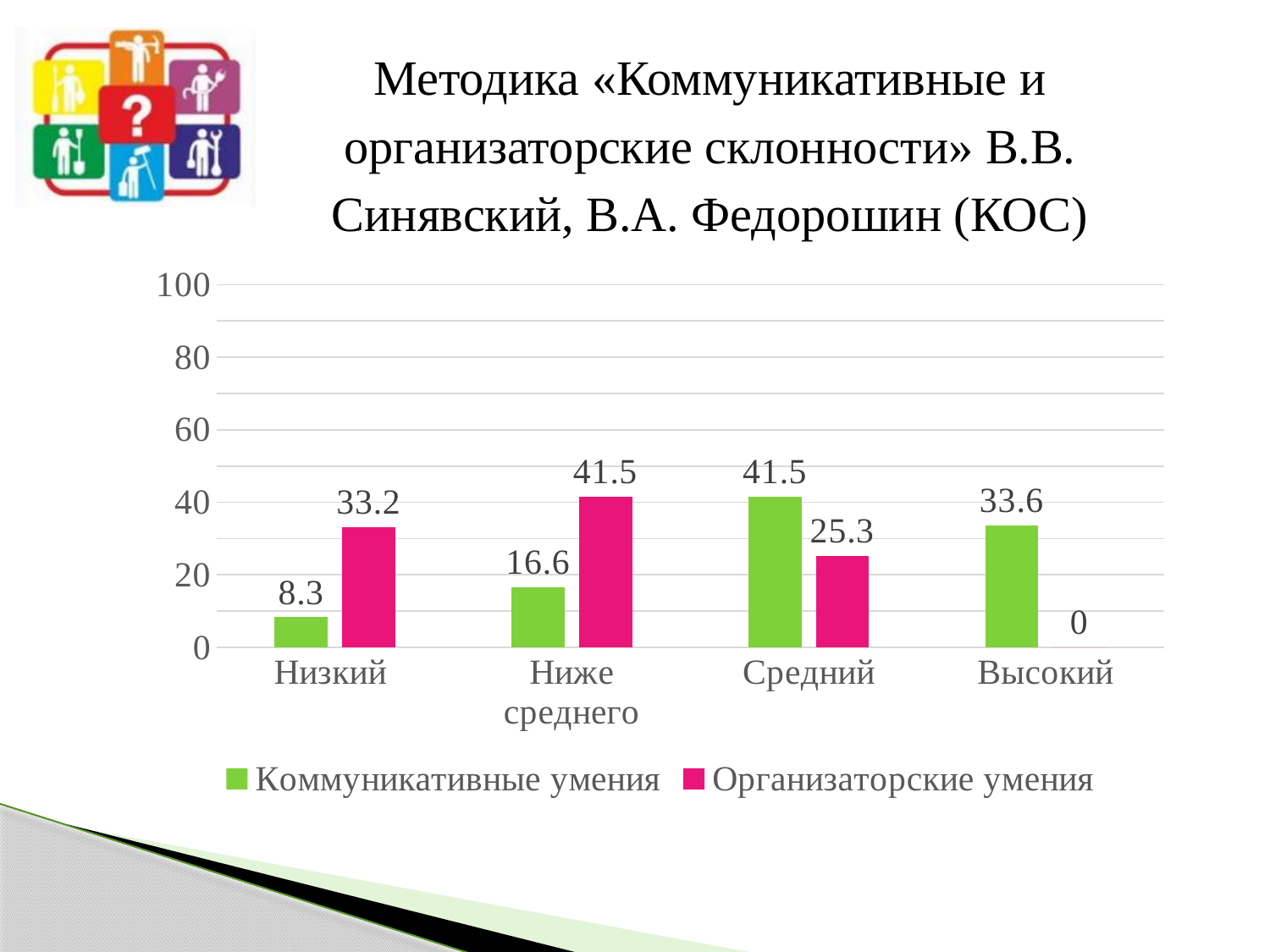
What colour are the bars for Организаторские умения? Pink Which category has the lowest value for Организаторские умения? Высокий What is the difference between Организаторские умения and Коммуникативные умения in the Низкий category? 24.9 What is the value for Организаторские умения in the Ниже среднего category? 41.5 How many series does the legend list? 2 What kind of chart is shown on the slide? Bar chart Which category has the highest value for Коммуникативные умения? Средний What is the value for Коммуникативные умения in the Низкий category? 8.3 Is the value for Коммуникативные умения in the Высокий category greater or less than 20? greater In the Средний category, which series has the larger value, Коммуникативные умения or Организаторские умения? Коммуникативные умения How many categories are shown on the x axis? 4 What is the value for Организаторские умения in the Высокий category? 0